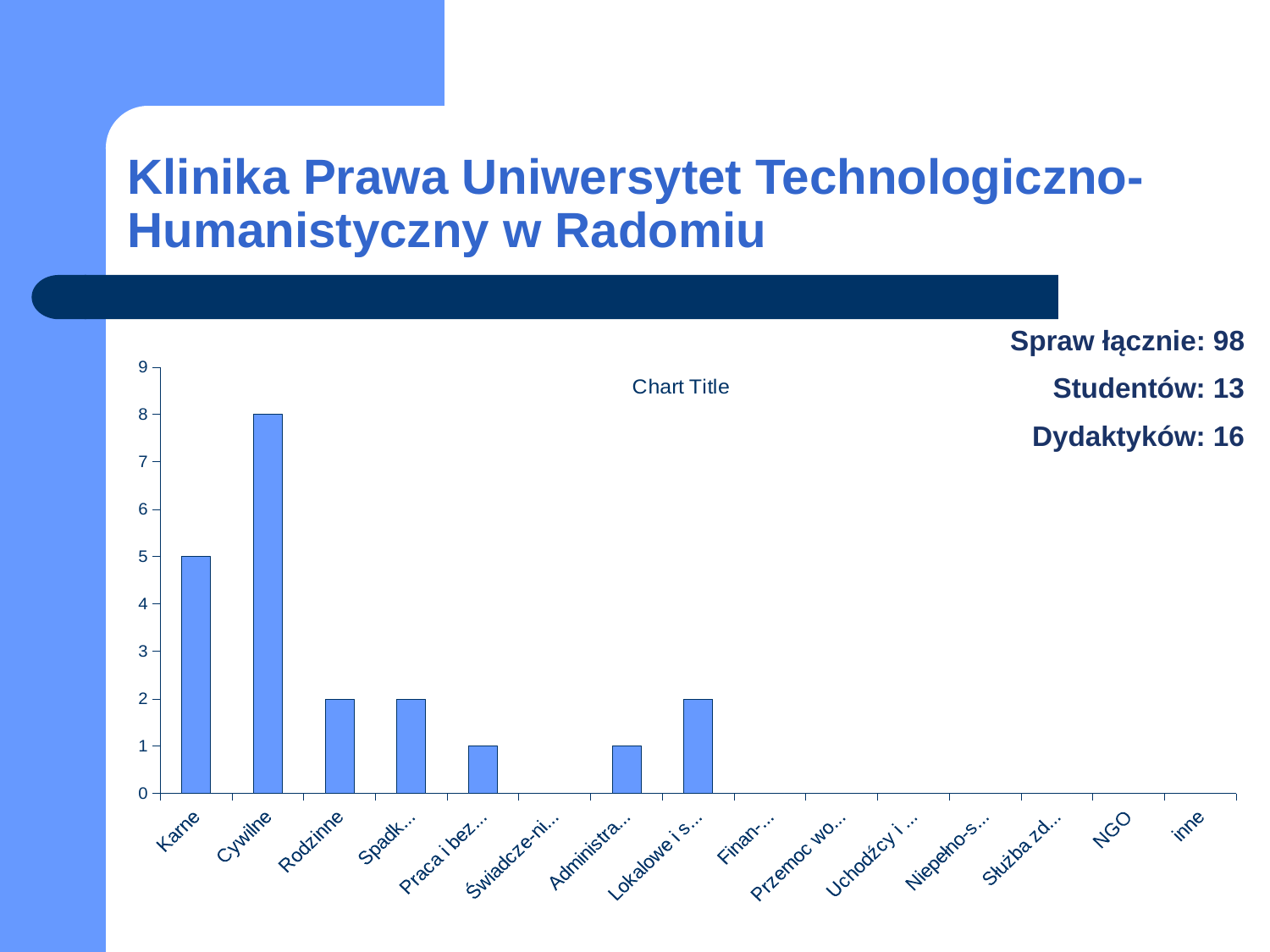
What is the value for NGO? 0 What is the value for Rodzinne? 2 What is the value for Karne? 5 Is the value for Cywilne greater or less than 6? greater Which is larger, the value for Karne or the value for Rodzinne? Karne What kind of chart is shown on the slide? bar chart How many categories are shown on the x axis? 15 What is the title shown on the chart? Chart Title What is the difference between the values for Cywilne and Karne? 3 What is the difference between the values for Karne and Rodzinne? 3 What is the value for Cywilne? 8 Which category has the highest value? Cywilne